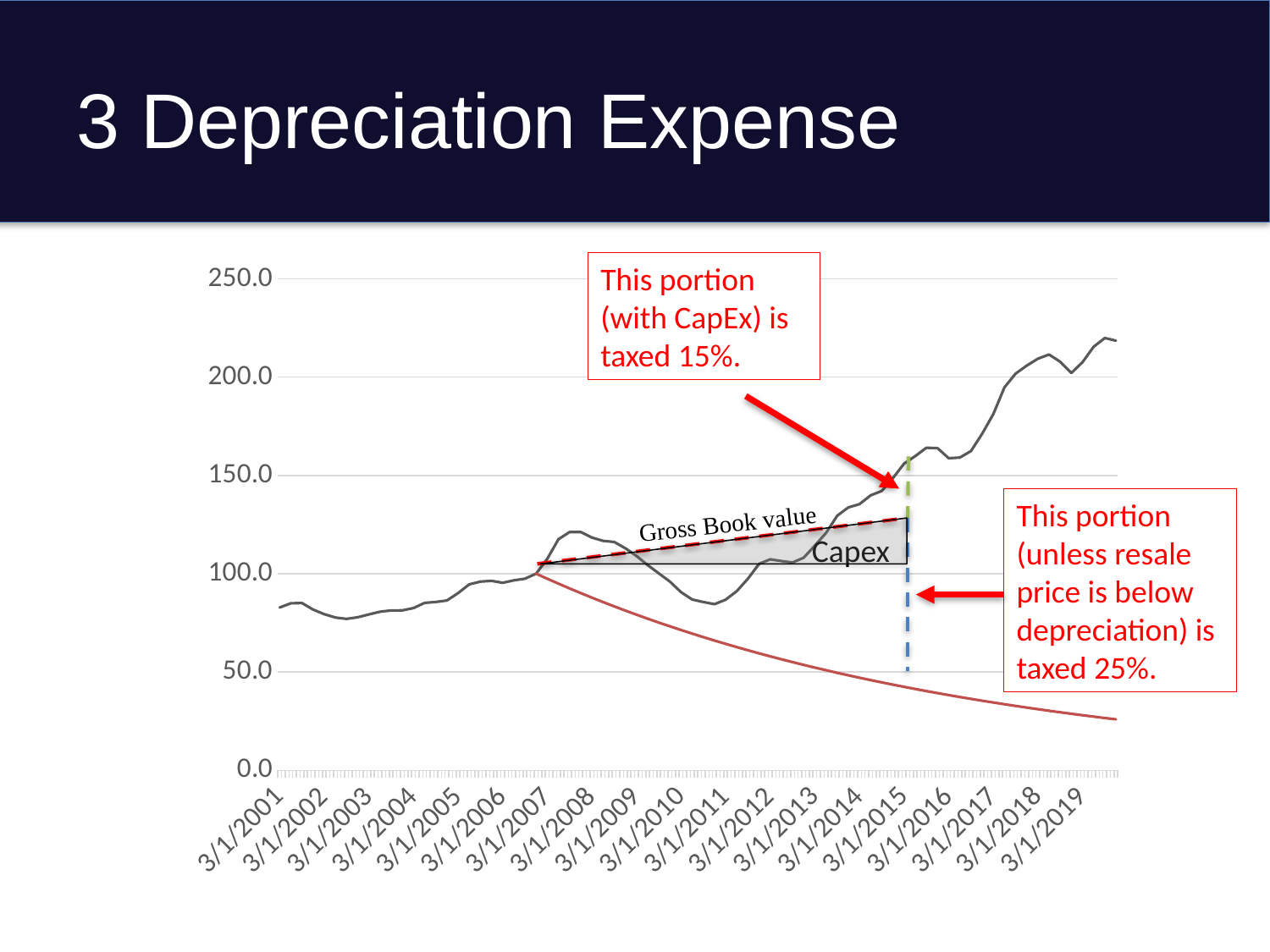
Is the value of the main line at 3/1/2008 greater or less than 100.0? greater Is the value of the main line at 3/1/2001 greater or less than 100.0? less Is the value of the main line at 3/1/2017 greater or less than 150.0? greater What kind of chart is shown on the slide? line chart What is the highest value shown on the y axis? 250.0 How many date labels are shown on the x axis? 19 Which is larger, the value of the main line at 3/1/2001 or at 3/1/2019? 3/1/2019 Overall, does the main line rise or fall from 3/1/2001 to 3/1/2019? rise What label is written on the shaded area under the dashed line? Capex